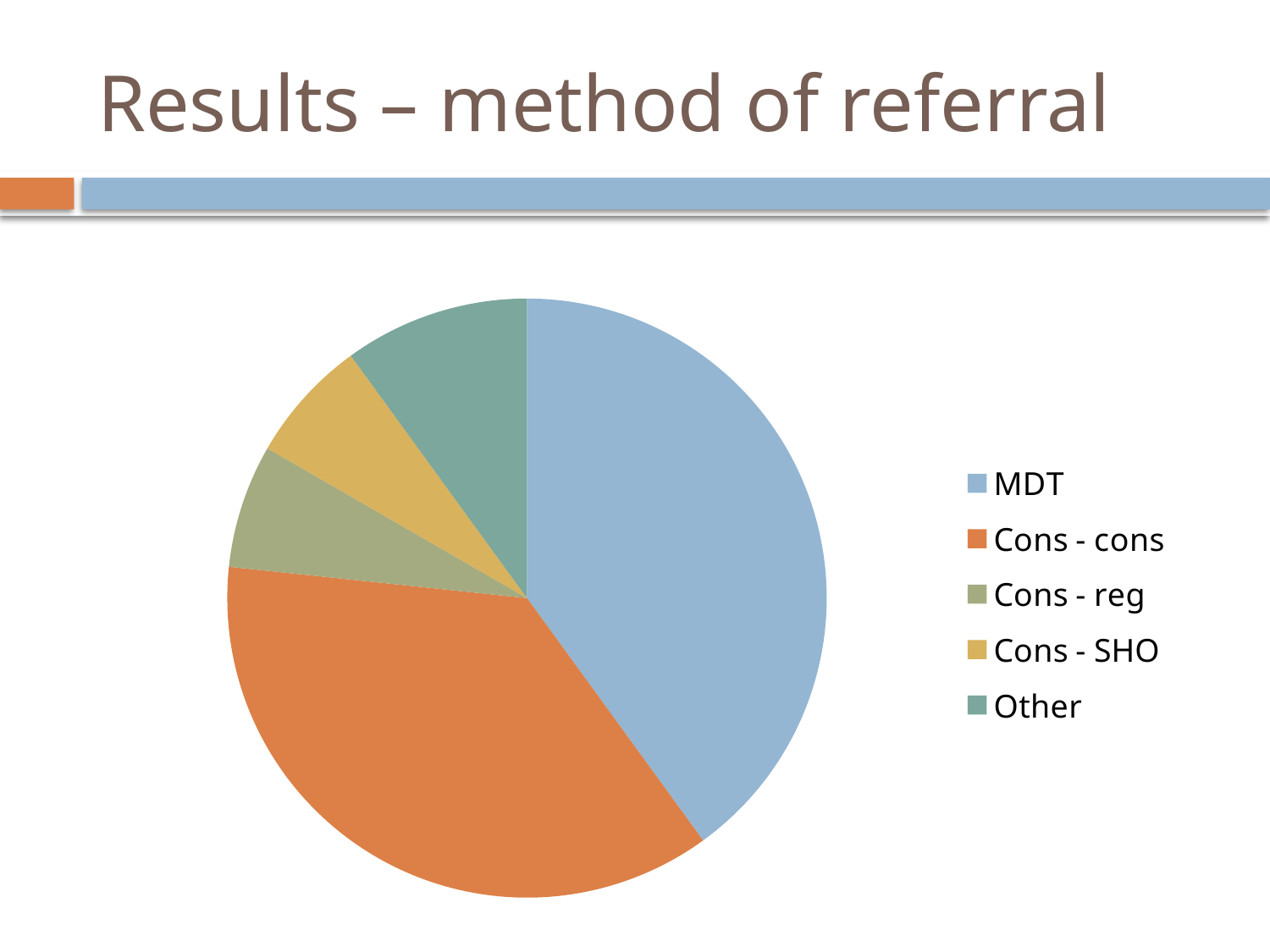
Which is larger, the slice for MDT or the slice for Other? MDT Which is larger, the slice for Cons - cons or the slice for Cons - reg? Cons - cons What type of chart is shown on the slide? pie chart Which is larger, the slice for Other or the slice for Cons - reg? Other What colour is the slice for Cons - cons in the pie chart? orange What is the title of the slide containing the pie chart? Results – method of referral Which method of referral has the largest slice of the pie? MDT How many entries does the legend list? 5 How many categories does the pie chart show? 5